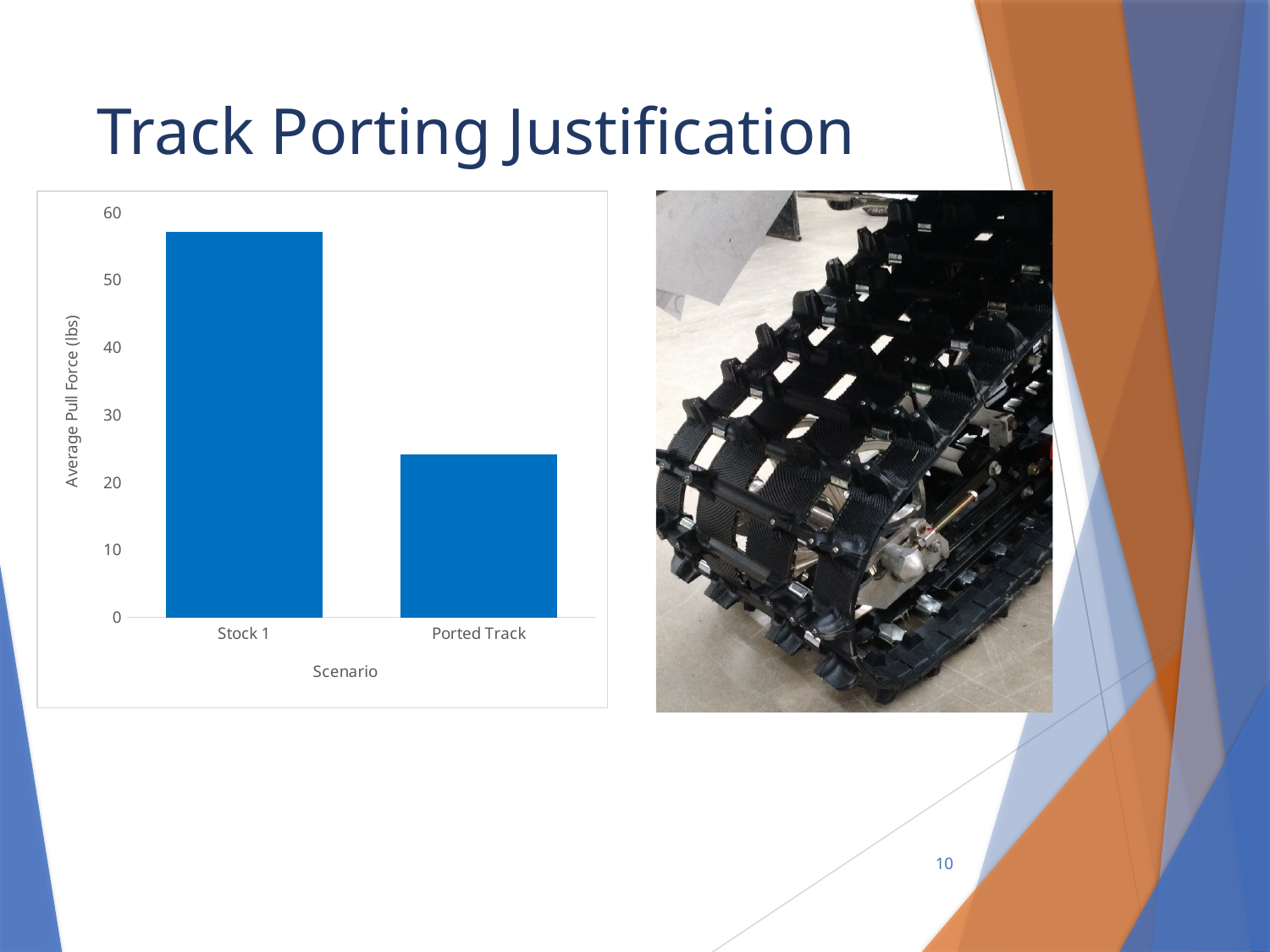
Which scenario has the lowest average pull force? Ported Track How many categories are plotted on the x axis of the chart? 2 Is the average pull force for Ported Track greater or less than 30? less Which has a larger average pull force, Stock 1 or Ported Track? Stock 1 Is the average pull force for Ported Track greater or less than 20? greater What kind of chart is shown on the slide? bar chart Do the bar values rise or fall from Stock 1 to Ported Track? fall Which scenario has the highest average pull force? Stock 1 Is the average pull force for Stock 1 greater or less than 50? greater What is the label on the vertical axis of the chart? Average Pull Force (lbs) What is the label on the horizontal axis of the chart? Scenario